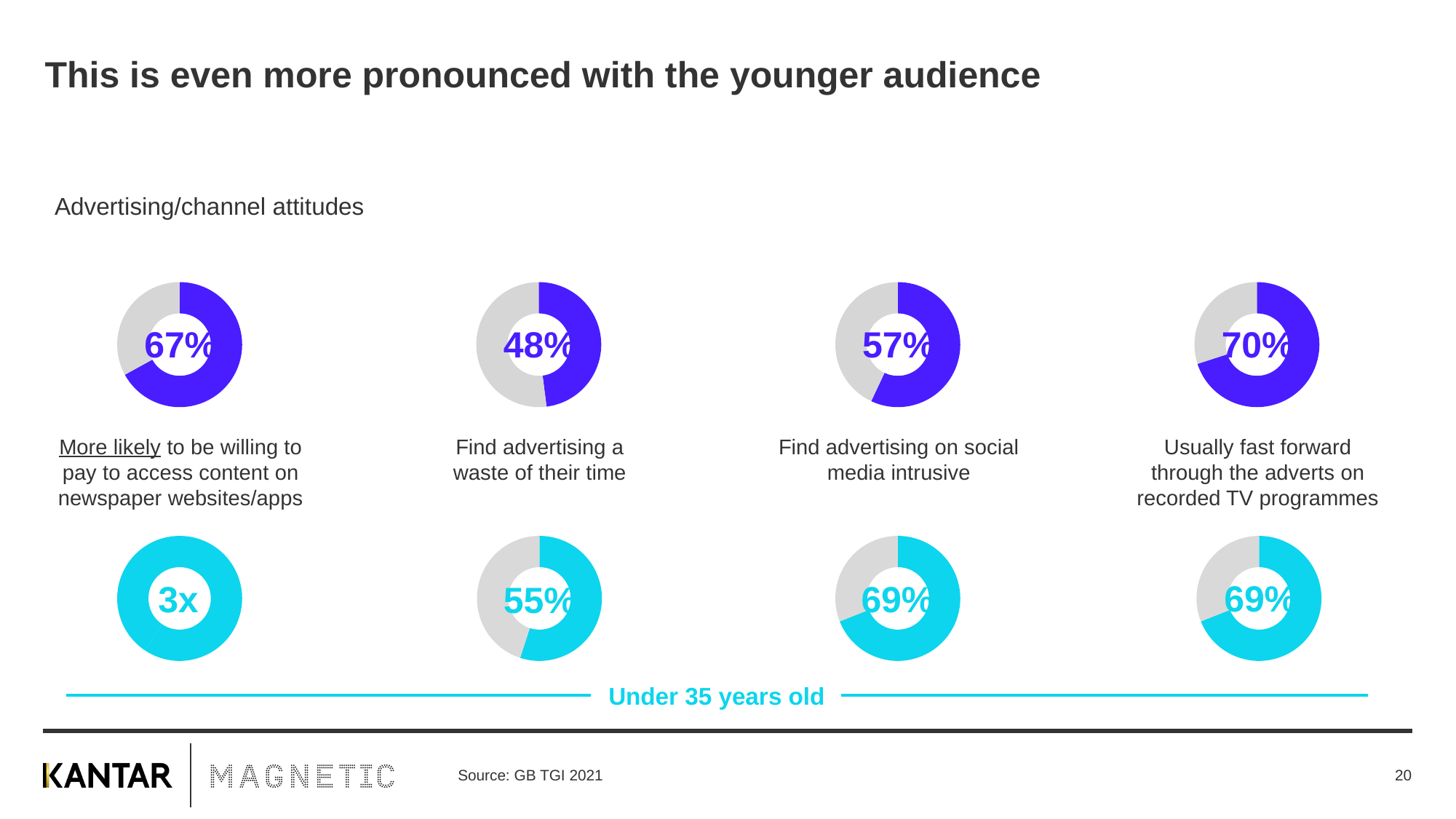
In the top-row donut chart for 'More likely to be willing to pay to access content on newspaper websites/apps', what value is shown? 67% In the bottom-row (Under 35 years old) donut chart for 'Usually fast forward through the adverts on recorded TV programmes', what value is shown? 69% What is the difference between the Under 35 value and the top-row value for 'Find advertising on social media intrusive'? 12 percentage points How many donut charts are shown on the slide? 8 What value is shown in the bottom-row (Under 35 years old) donut chart for 'More likely to be willing to pay to access content on newspaper websites/apps'? 3x Among the top-row donut charts, which attitude has the lowest percentage? Find advertising a waste of their time In the top-row donut chart for 'Find advertising a waste of their time', what value is shown? 48% In the bottom-row (Under 35 years old) donut chart for 'Find advertising a waste of their time', what value is shown? 55% Among the top-row donut charts, which attitude has the highest percentage? Usually fast forward through the adverts on recorded TV programmes What type of chart is used to display the percentages on this slide? Donut (pie) chart For 'Find advertising a waste of their time', which is larger: the top-row value or the Under 35 years old value? Under 35 years old In the top-row donut chart for 'Find advertising on social media intrusive', what value is shown? 57%